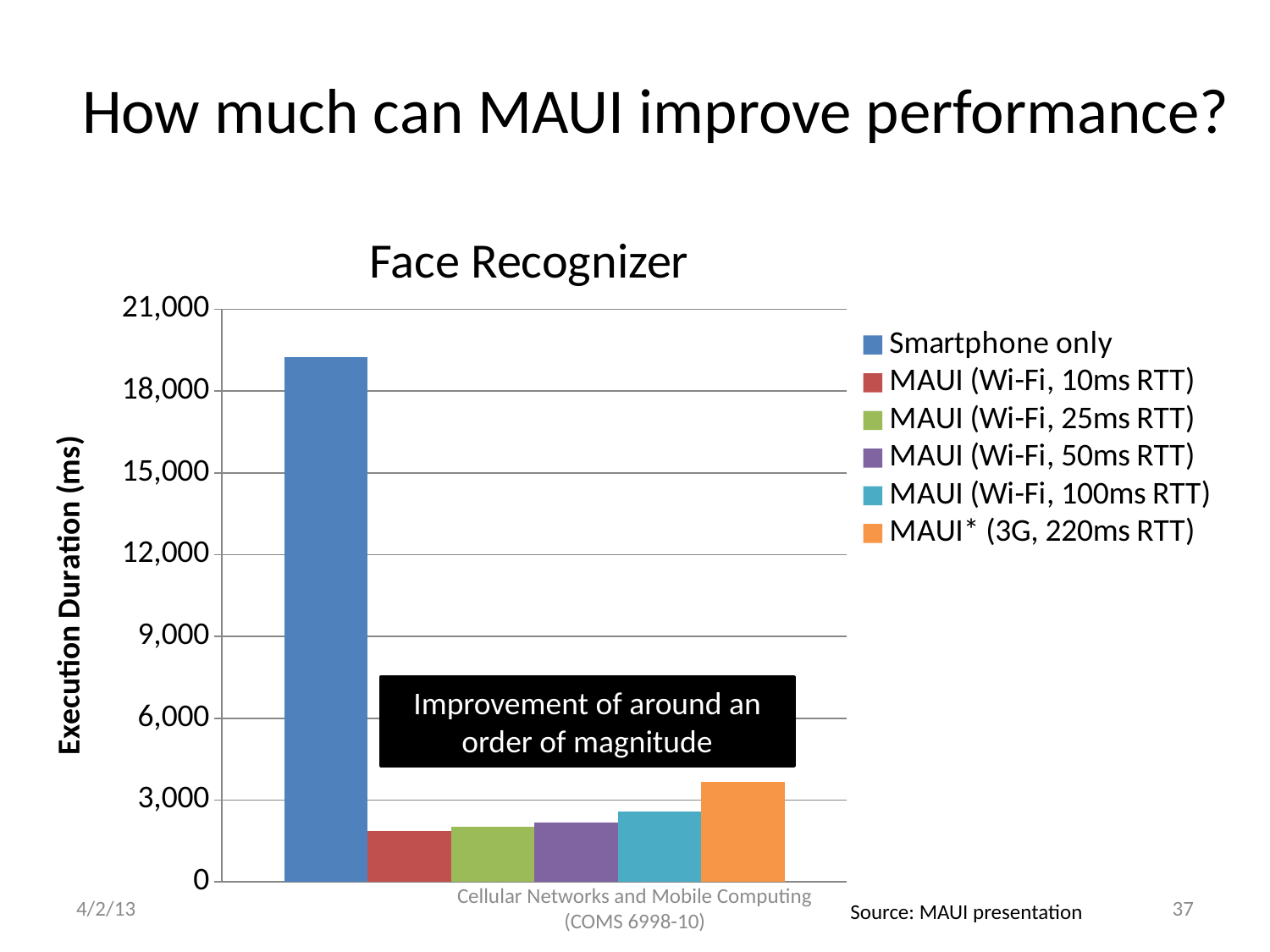
Which is larger, the value for Smartphone only or the value for MAUI* (3G, 220ms RTT)? Smartphone only How many series does the chart legend list? 6 Which series has the highest execution duration? Smartphone only Is the value for MAUI* (3G, 220ms RTT) greater or less than 3,000? greater What type of chart is shown on the slide? bar chart What is the title of the chart? Face Recognizer What is the label on the vertical axis of the chart? Execution Duration (ms) Is the value for MAUI (Wi-Fi, 10ms RTT) greater or less than 3,000? less Is the value for Smartphone only greater or less than 18,000? greater Which is larger, the value for MAUI (Wi-Fi, 100ms RTT) or the value for MAUI* (3G, 220ms RTT)? MAUI* (3G, 220ms RTT) How many bars are plotted in the chart? 6 Across the MAUI bars, do the execution durations rise or fall as the RTT increases from 10ms to 220ms? rise